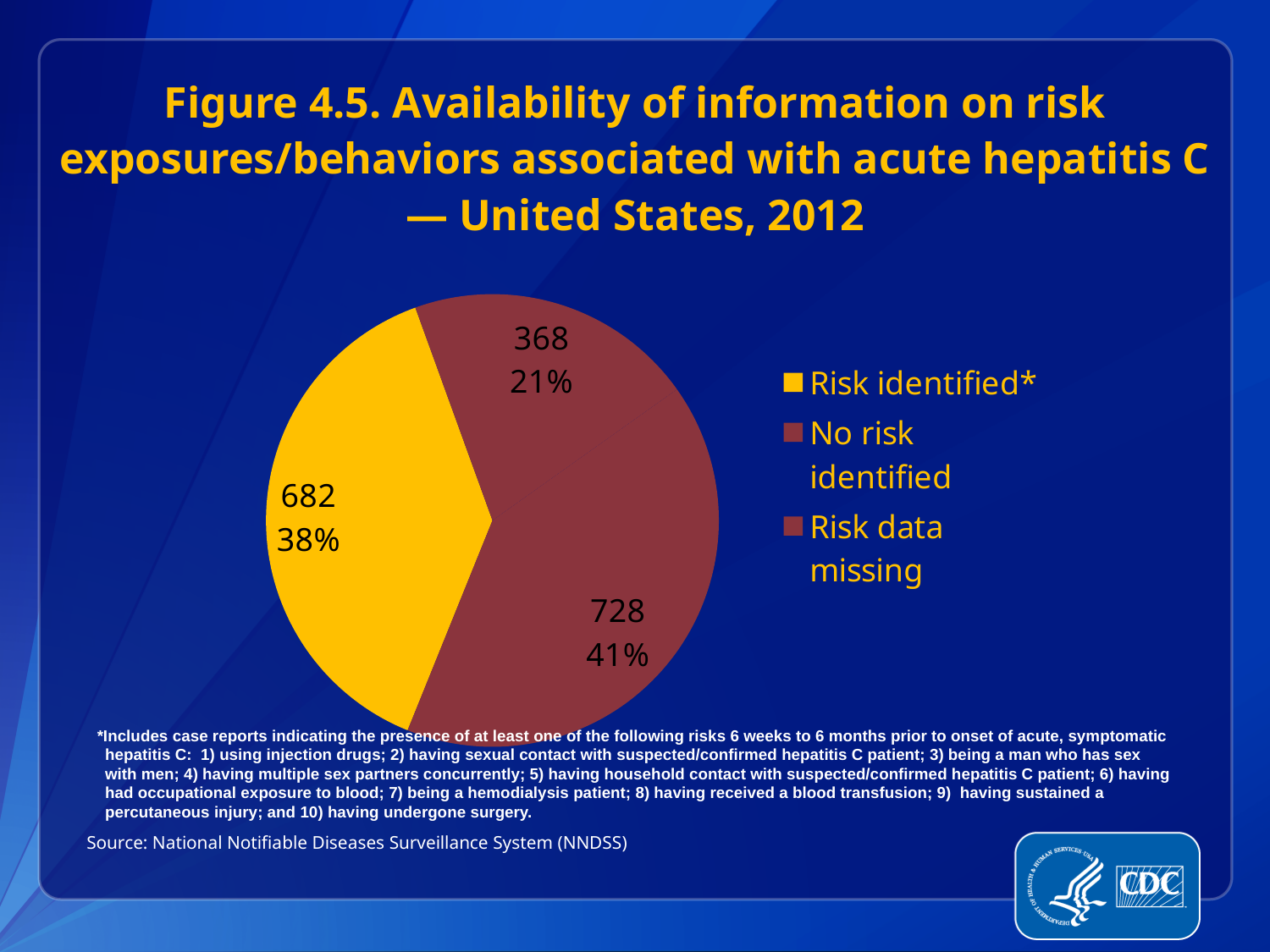
What count is shown for the slice labeled 21%? 368 Is the Risk identified* slice larger or smaller than the slice labeled 728? smaller What is the difference between the largest slice (728) and the smallest slice (368)? 360 How many slices does the pie chart have? 3 How many entries does the legend list? 3 What is the total number of cases across all three slices of the pie? 1778 What kind of chart is shown on the slide? pie chart What share of the pie does the Risk identified* slice represent? 38% What is the difference between the slice labeled 728 and the Risk identified* slice? 46 What colour is used for the Risk identified* slice? yellow How many cases are shown for the Risk identified* slice? 682 What percentage is shown for the slice labeled 728? 41%